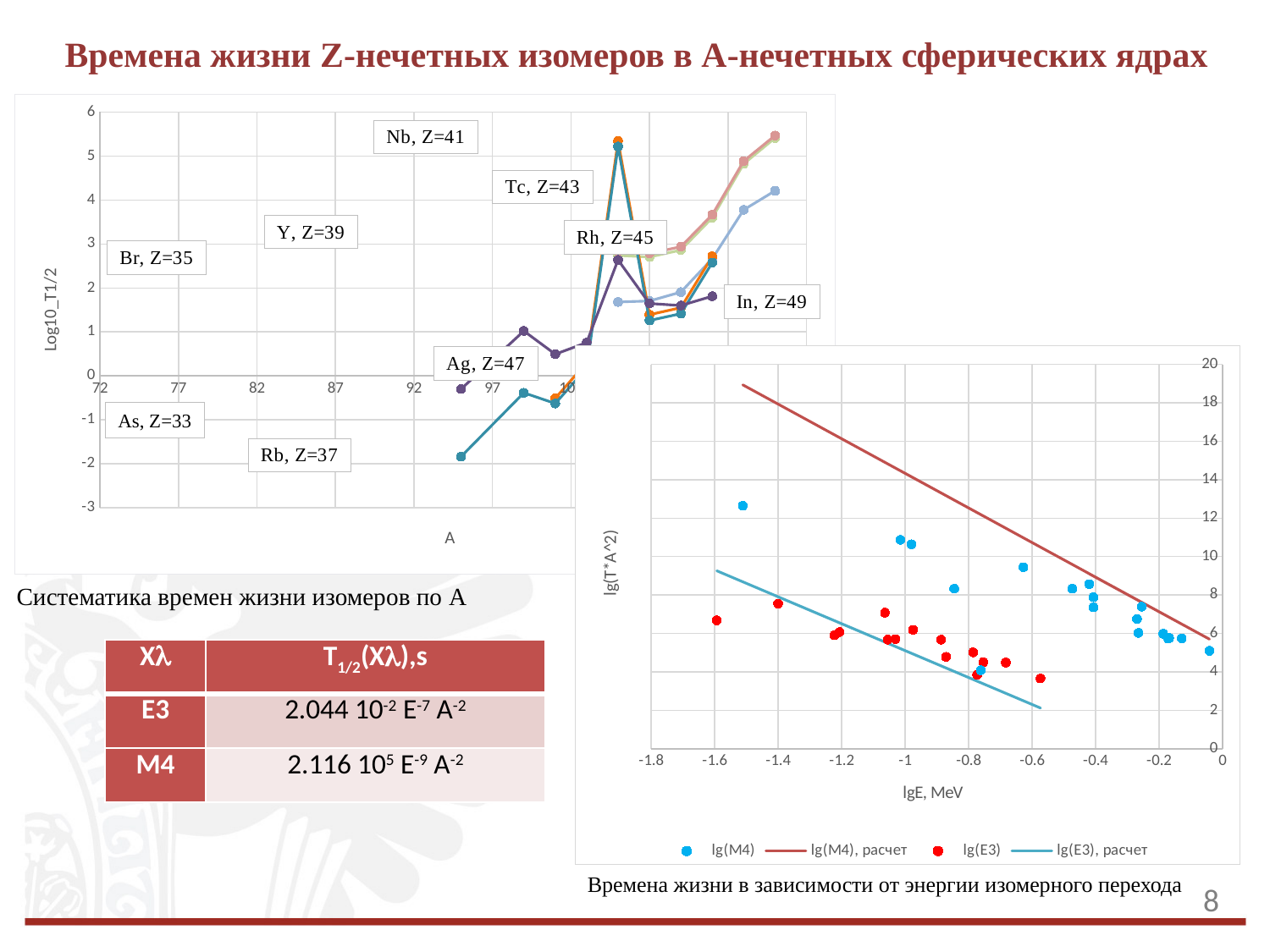
In the bottom-right chart, what is the x-axis title? lgE, MeV In the bottom-right chart, which series is plotted with red dots? lg(E3) In the bottom-right chart, is the lg(M4) point near lgE = -1.5 greater or less than 10? greater In the bottom-right chart, does the 'lg(M4), расчет' line rise or fall as lgE increases from -1.6 to 0? fall In the top-left chart, is the highest peak of the Nb, Z=41 / Tc, Z=43 curves greater or less than 5 on the Log10_T1/2 axis? greater How many series does the legend of the bottom-right chart list? 4 What kind of chart is the bottom-right chart titled 'Времена жизни в зависимости от энергии изомерного перехода'? scatter chart In the bottom-right chart, does the 'lg(E3), расчет' line rise or fall as lgE increases? fall How many element labels (such as 'Nb, Z=41') are shown on the top-left chart? 9 What kind of chart is the top-left chart 'Систематика времен жизни изомеров по A'? line chart In the top-left chart, is the lowest plotted point (near A = 95) greater or less than -1 on the Log10_T1/2 axis? less